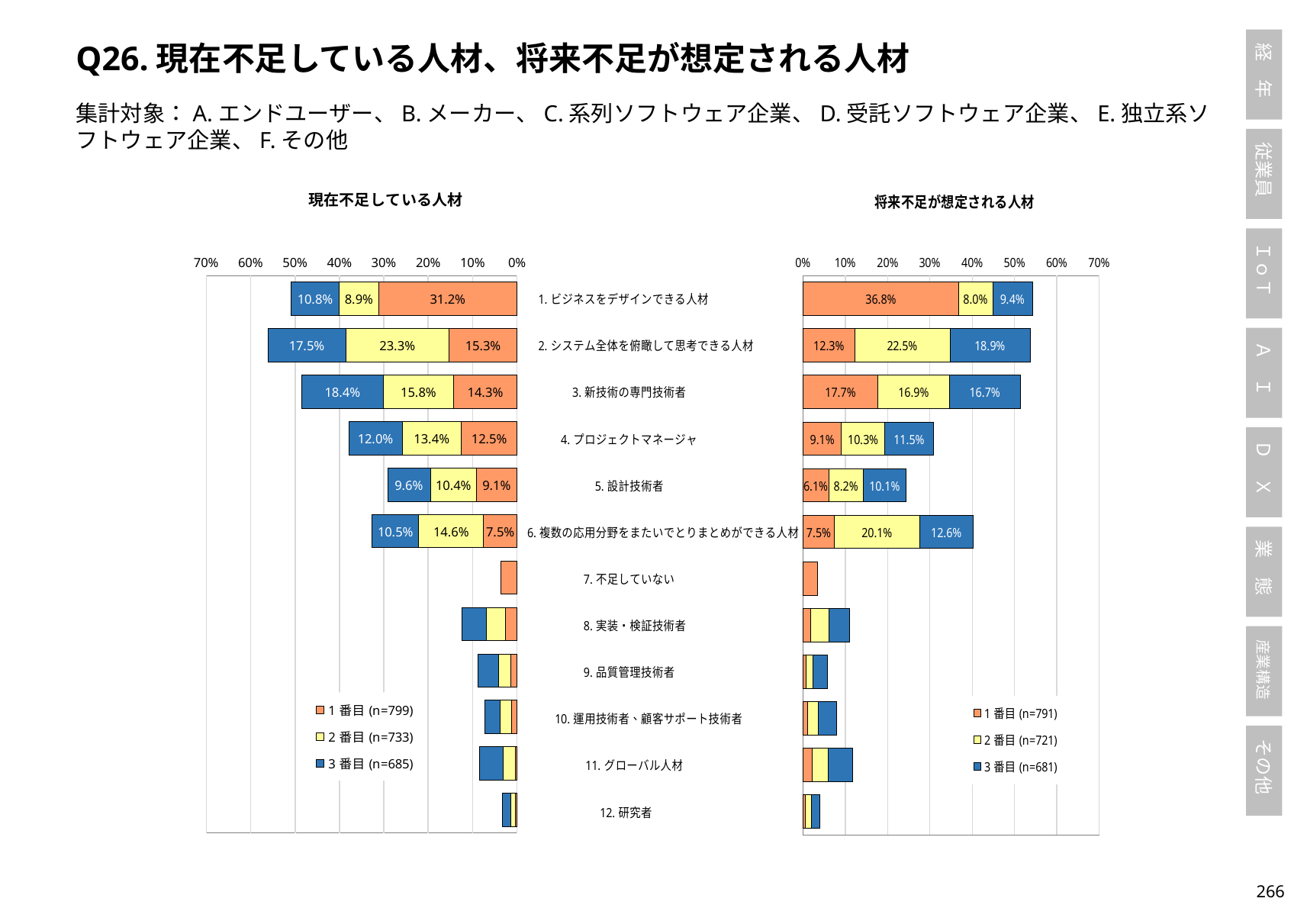
What kind of chart is the left chart titled 現在不足している人材? Stacked bar chart What is the sample size (n) shown in the legend for 1番目 in the left chart 現在不足している人材? n=799 How many series does the legend of the right chart 将来不足が想定される人材 list? 3 In the right chart 将来不足が想定される人材, what is the 2番目 value for 6. 複数の応用分野をまたいでとりまとめができる人材? 20.1% In the left chart 現在不足している人材, what is the 1番目 value for 1. ビジネスをデザインできる人材? 31.2% In the right chart 将来不足が想定される人材, is the total bar length for 11. グローバル人材 greater or less than 20%? less How many categories are listed on the left chart 現在不足している人材? 12 In the right chart 将来不足が想定される人材, which category has the highest 1番目 value? 1. ビジネスをデザインできる人材 In the right chart 将来不足が想定される人材, what is the total of the stacked bar for 1. ビジネスをデザインできる人材? 54.2% In the left chart 現在不足している人材, which is larger: the 3番目 value for 3. 新技術の専門技術者 or the 3番目 value for 4. プロジェクトマネージャ? 3. 新技術の専門技術者 In the left chart 現在不足している人材, what is the total of the stacked bar for 2. システム全体を俯瞰して思考できる人材? 56.1% In the left chart 現在不足している人材, what is the difference between the 1番目 values for 1. ビジネスをデザインできる人材 and 2. システム全体を俯瞰して思考できる人材? 15.9 percentage points